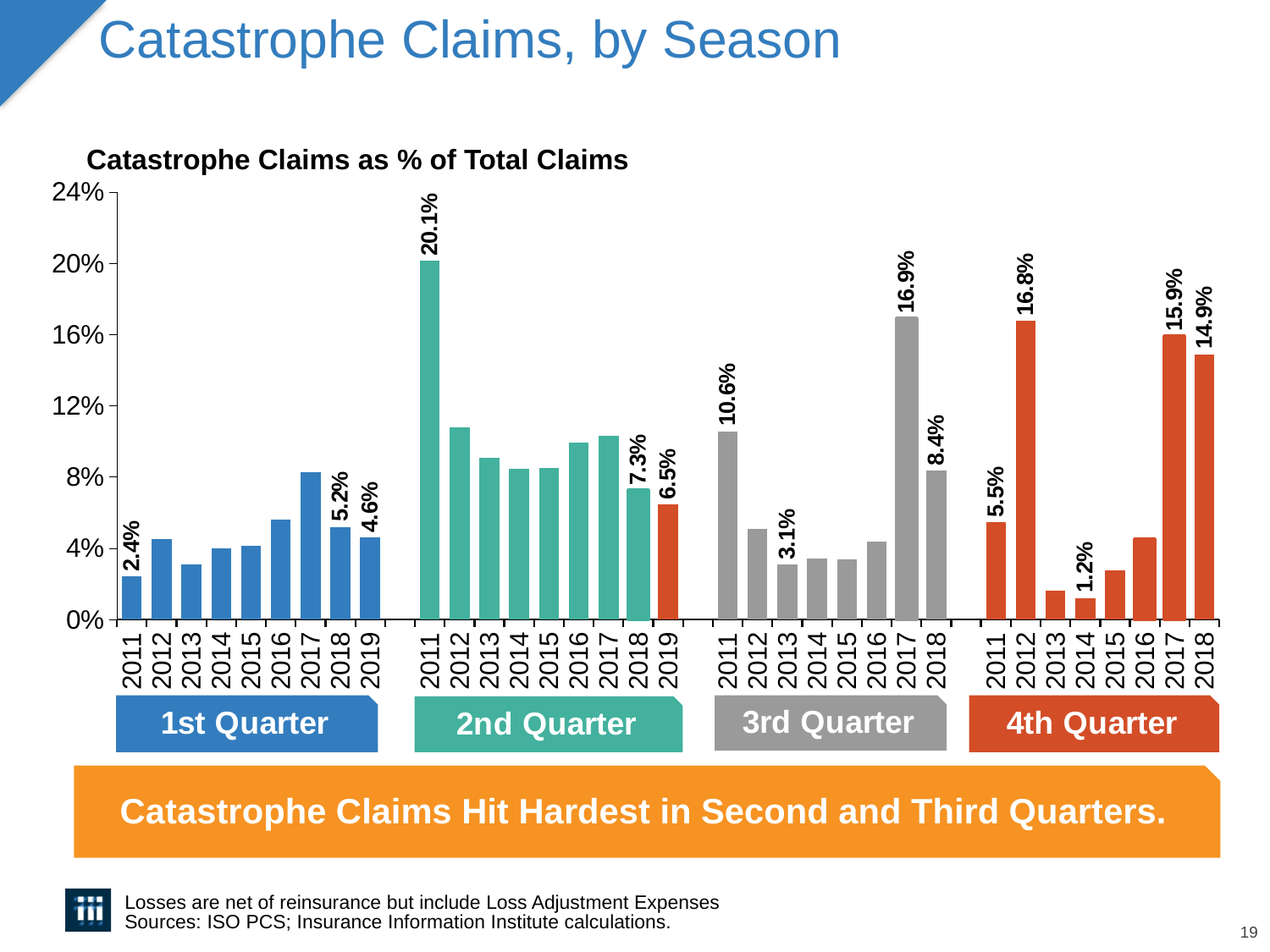
Which bar on the chart has the highest value? 2011, 2nd Quarter (20.1%) What type of chart is shown on the slide? Bar chart Which is larger: the 2011 value in the 2nd Quarter group or the 2017 value in the 3rd Quarter group? 2011 in the 2nd Quarter group How many years are shown in the 1st Quarter group? 9 What is the difference between the 2011 and 2019 values in the 2nd Quarter group? 13.6 percentage points What is the value shown for 2017 in the 3rd Quarter group? 16.9% What is the value shown for 2014 in the 4th Quarter group? 1.2% Which bar on the chart has the lowest value? 2014, 4th Quarter (1.2%) Is the value for 2013 in the 4th Quarter group greater or less than 4%? less What is the title of the chart? Catastrophe Claims as % of Total Claims What is the catastrophe claims percentage for 2011 in the 2nd Quarter group? 20.1% What is the value shown for 2019 in the 1st Quarter group? 4.6%